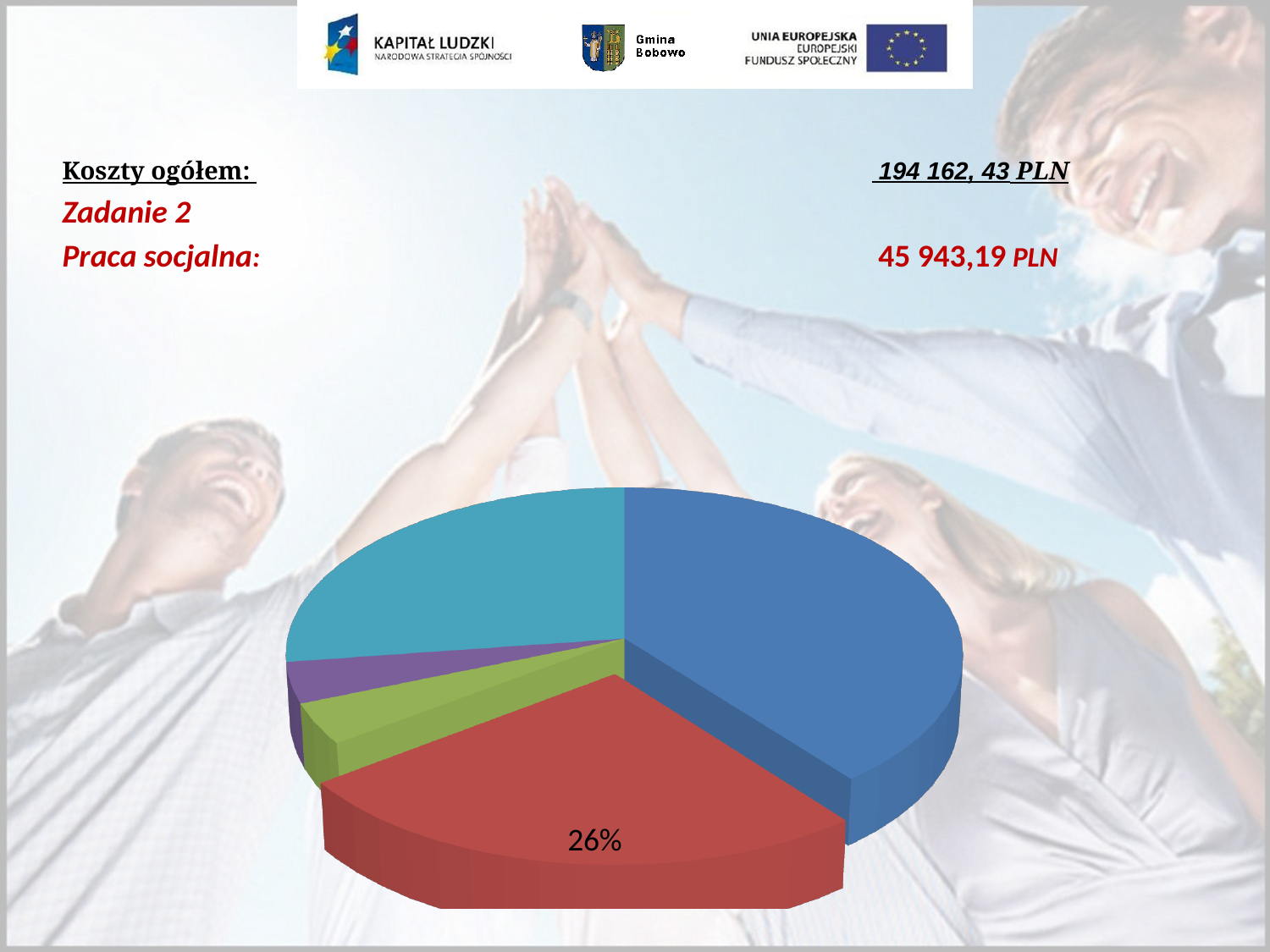
Which is larger, the blue slice or the teal slice? blue slice What share of the pie does the red slice represent? 26% What percentage is printed on the red slice of the pie chart? 26% Which colour slice is the largest in the pie chart? blue What colour is the slice labelled 26%? red Which is larger, the red slice or the green slice? red slice How many slices in the pie chart have a percentage label printed on them? 1 How many slices does the pie chart have? 5 What kind of chart is shown on the slide? pie chart Which is larger, the blue slice or the red slice? blue slice